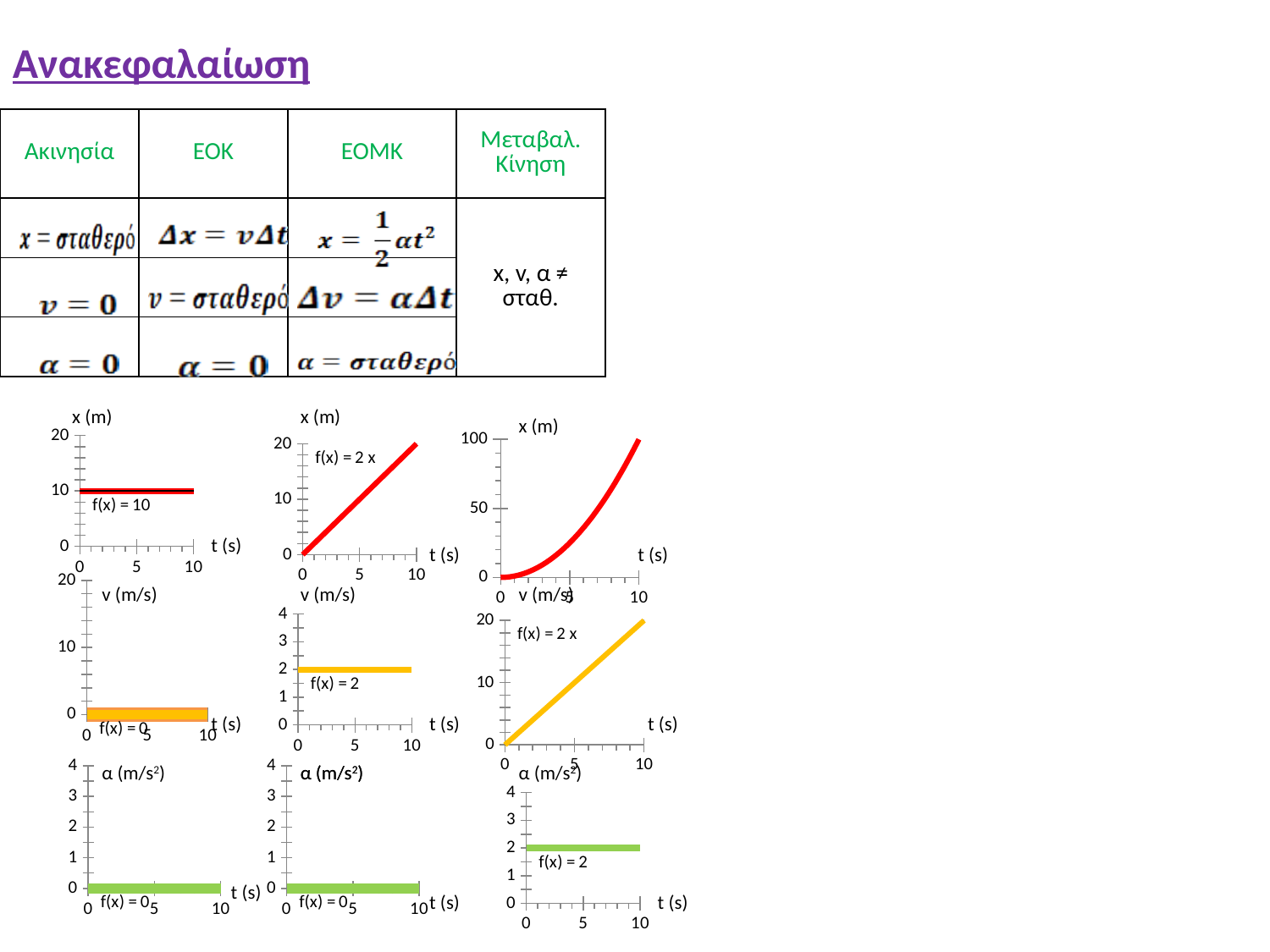
In the top-left x (m) chart, does the value of x rise, fall or stay constant as t increases? Stays constant What is the highest value shown on the vertical axis of the top-right x (m) chart? 100 In the middle-left v (m/s) chart, what constant value does the line show? 0 In the top-left x (m) chart, what function label is printed next to the line? f(x) = 10 In the top-right x (m) chart, is the value of x at t = 5 s greater or less than 50? less How many charts are shown on the slide? 9 In the bottom-right α (m/s²) chart, what function label is printed next to the line? f(x) = 2 What kind of charts are shown on the slide? Line charts In the top-middle x (m) chart, what function label is printed next to the line? f(x) = 2 x In the top-right x (m) chart, is the value of x at t = 10 s greater or less than 50? greater In the middle-center v (m/s) chart, what constant value does the line show? 2 In the top-middle x (m) chart, does the value of x rise or fall as t increases? Rises